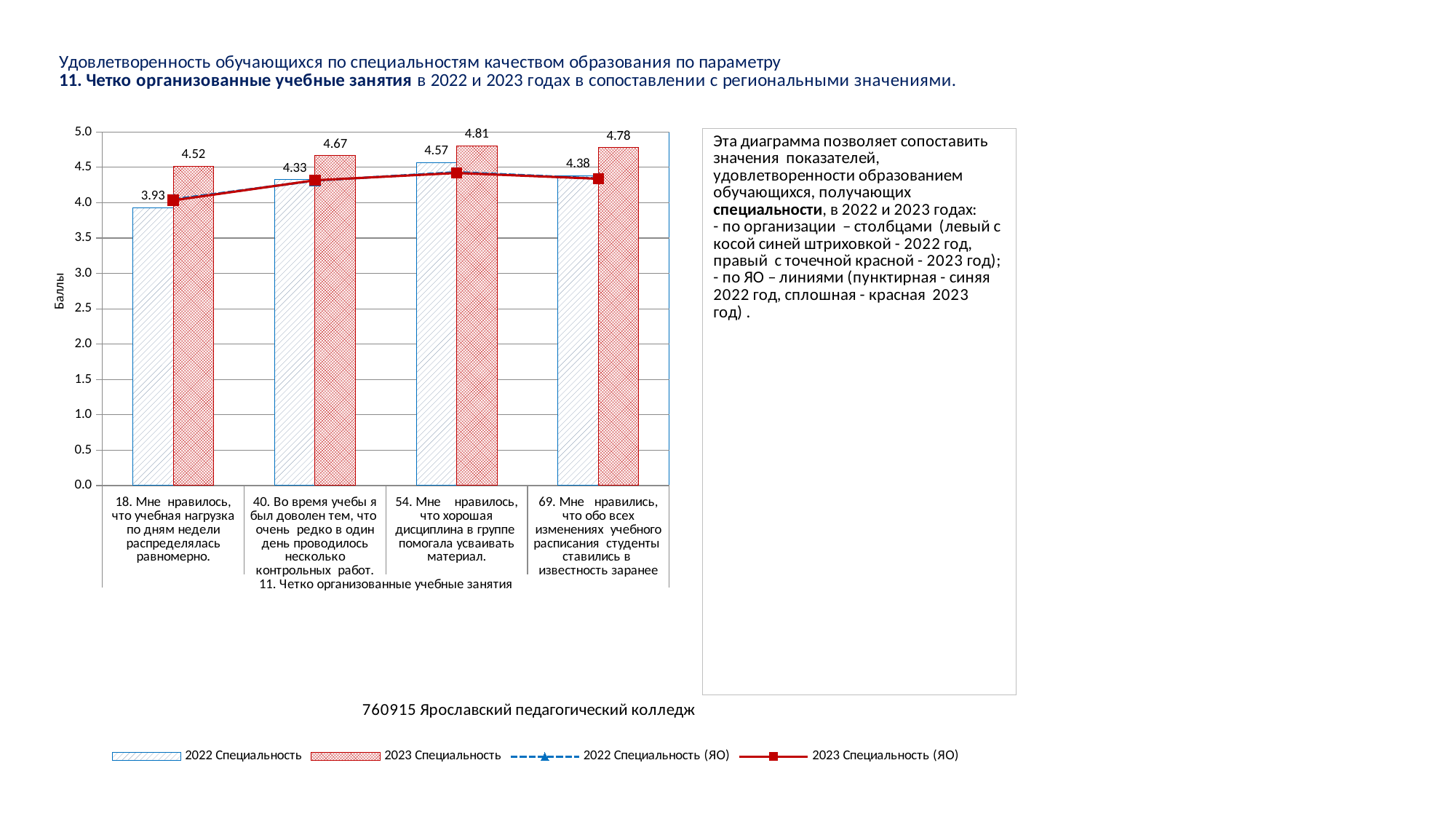
What is the 2023 Специальность value for item 69 (Мне нравились, что обо всех изменениях учебного расписания студенты ставились в известность заранее)? 4.78 Which is larger for item 40: the 2022 Специальность value or the 2023 Специальность value? 2023 Специальность What is the difference between the 2023 and 2022 Специальность values for item 18? 0.59 What kind of chart is shown on the slide? Bar chart with line series What is the 2022 Специальность value for item 18 (Мне нравилось, что учебная нагрузка по дням недели распределялась равномерно)? 3.93 How many categories (items) are shown on the x axis? 4 Which item has the highest 2022 Специальность value? 54. Мне нравилось, что хорошая дисциплина в группе помогала усваивать материал. What is the label of the y axis? Баллы What is the 2023 Специальность value for item 54 (Мне нравилось, что хорошая дисциплина в группе помогала усваивать материал)? 4.81 How many series does the legend list? 4 Which item has the lowest 2023 Специальность value? 18. Мне нравилось, что учебная нагрузка по дням недели распределялась равномерно. Is the 2022 Специальность value for item 18 greater or less than 4.0? less